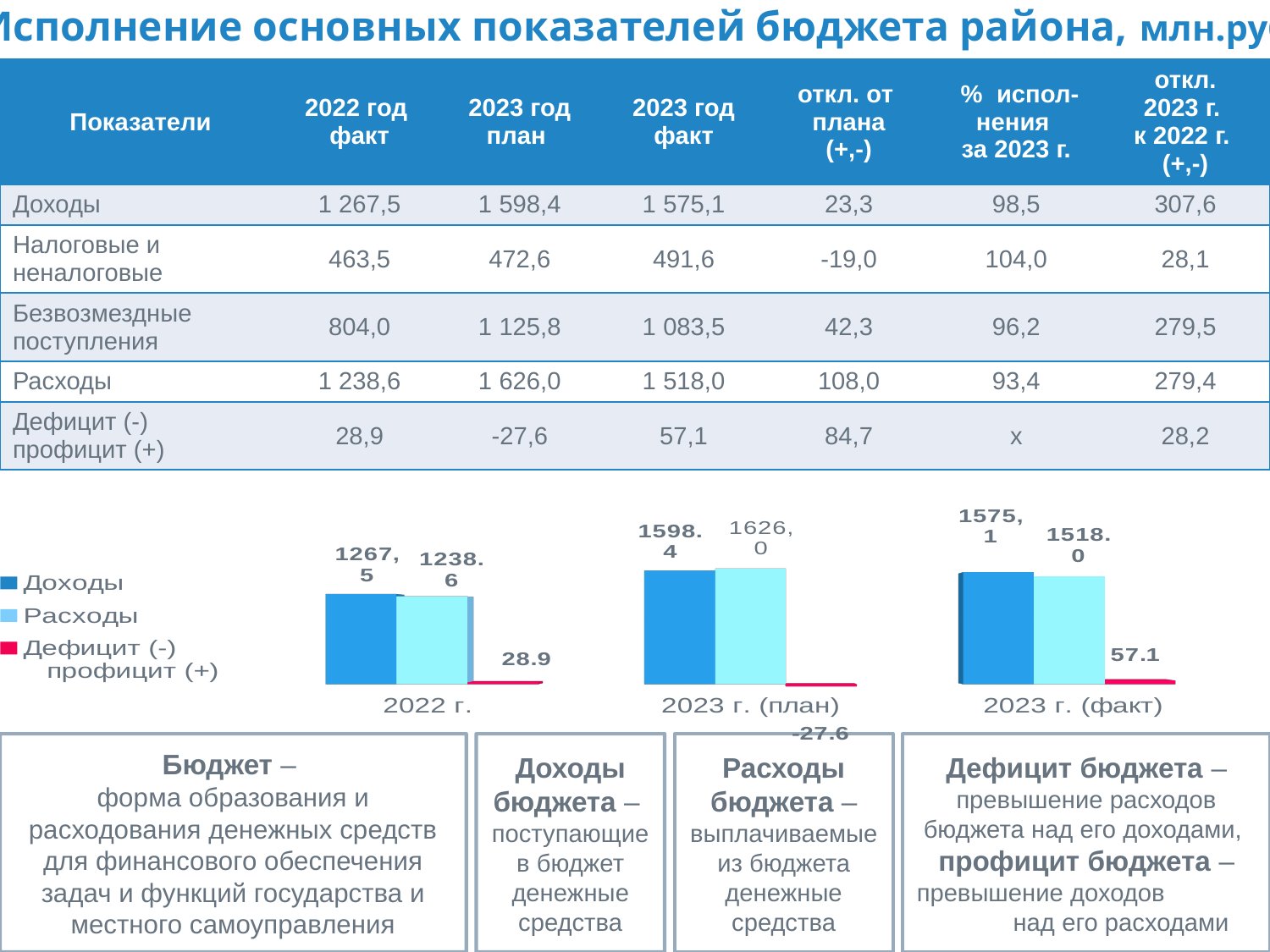
What is the value of Расходы for 2023 г. (план) in the chart? 1626,0 What is the value of Доходы for 2022 г. in the chart? 1267,5 In which category is Дефицит (-) профицит (+) lowest in the chart? 2023 г. (план) What is the value of Дефицит (-) профицит (+) for 2023 г. (факт) in the chart? 57.1 How many series does the chart legend list? 3 How many categories are shown on the x axis of the chart? 3 Does Доходы rise or fall from 2022 г. to 2023 г. (план) in the chart? rise What kind of chart is shown on the slide? bar chart For 2023 г. (факт), which is larger in the chart: Доходы or Расходы? Доходы In which category is Расходы highest in the chart? 2023 г. (план) What is the value of Расходы for 2022 г. in the chart? 1238.6 What is the difference between Доходы and Расходы for 2023 г. (факт) in the chart? 57,1